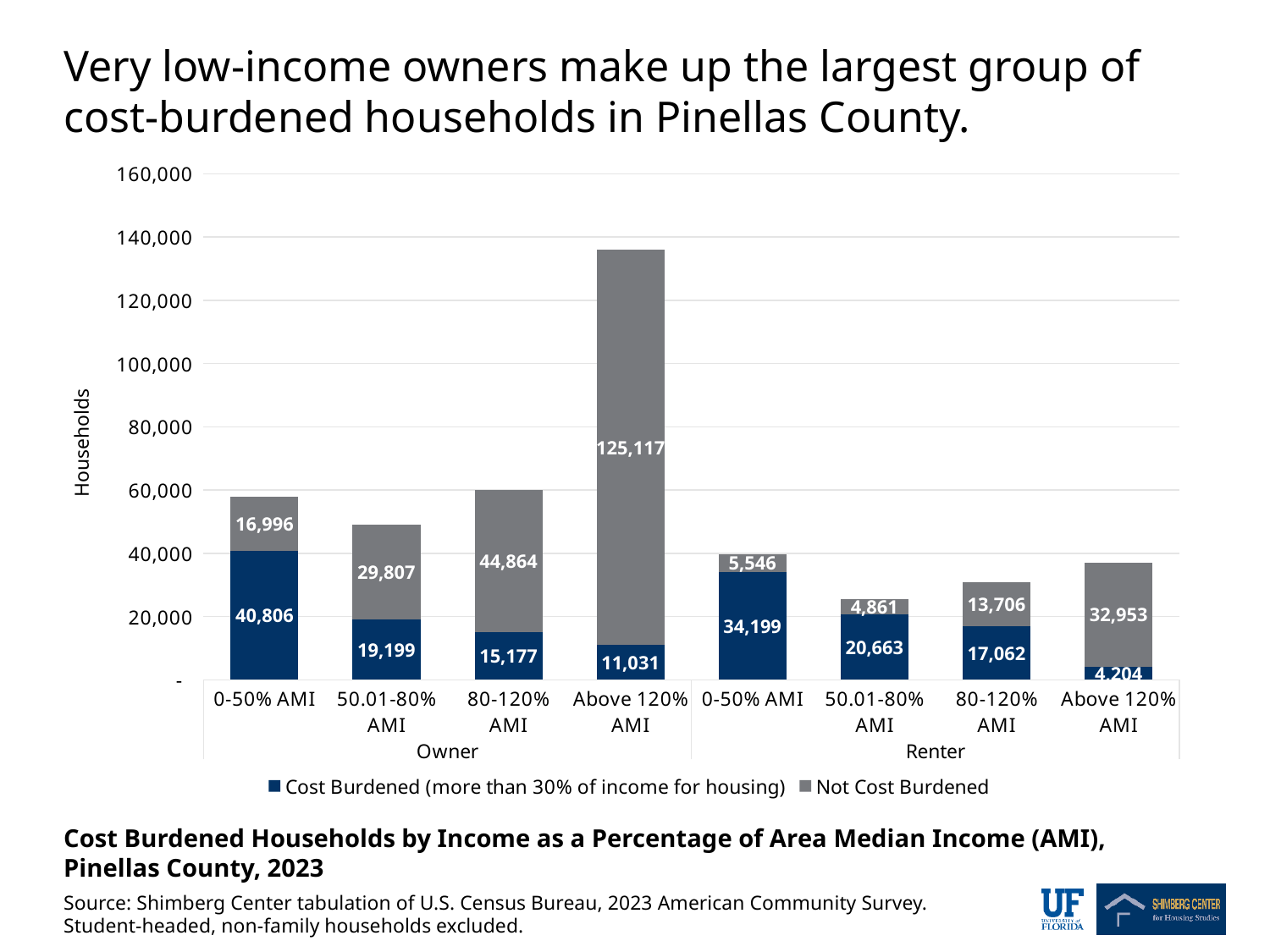
Which is larger: the number of not-cost-burdened renter households in the 50.01-80% AMI group or in the 80-120% AMI group? 80-120% AMI How many series does the legend list? 2 How many bars are shown in the chart? 8 How many cost-burdened owner households are there in the 0-50% AMI group? 40,806 Is the total height of the Owner Above 120% AMI bar greater or less than 120,000? greater Which category has the largest number of cost-burdened households? Owner, 0-50% AMI Which category has the smallest number of cost-burdened households? Renter, Above 120% AMI How many cost-burdened renter households are in the 80-120% AMI group? 17,062 What is the difference between cost-burdened owner households and cost-burdened renter households in the 0-50% AMI group? 6,607 What type of chart is shown on the slide? Stacked bar chart What is the total number of households in the Renter 0-50% AMI bar? 39,745 How many not-cost-burdened owner households are in the Above 120% AMI group? 125,117